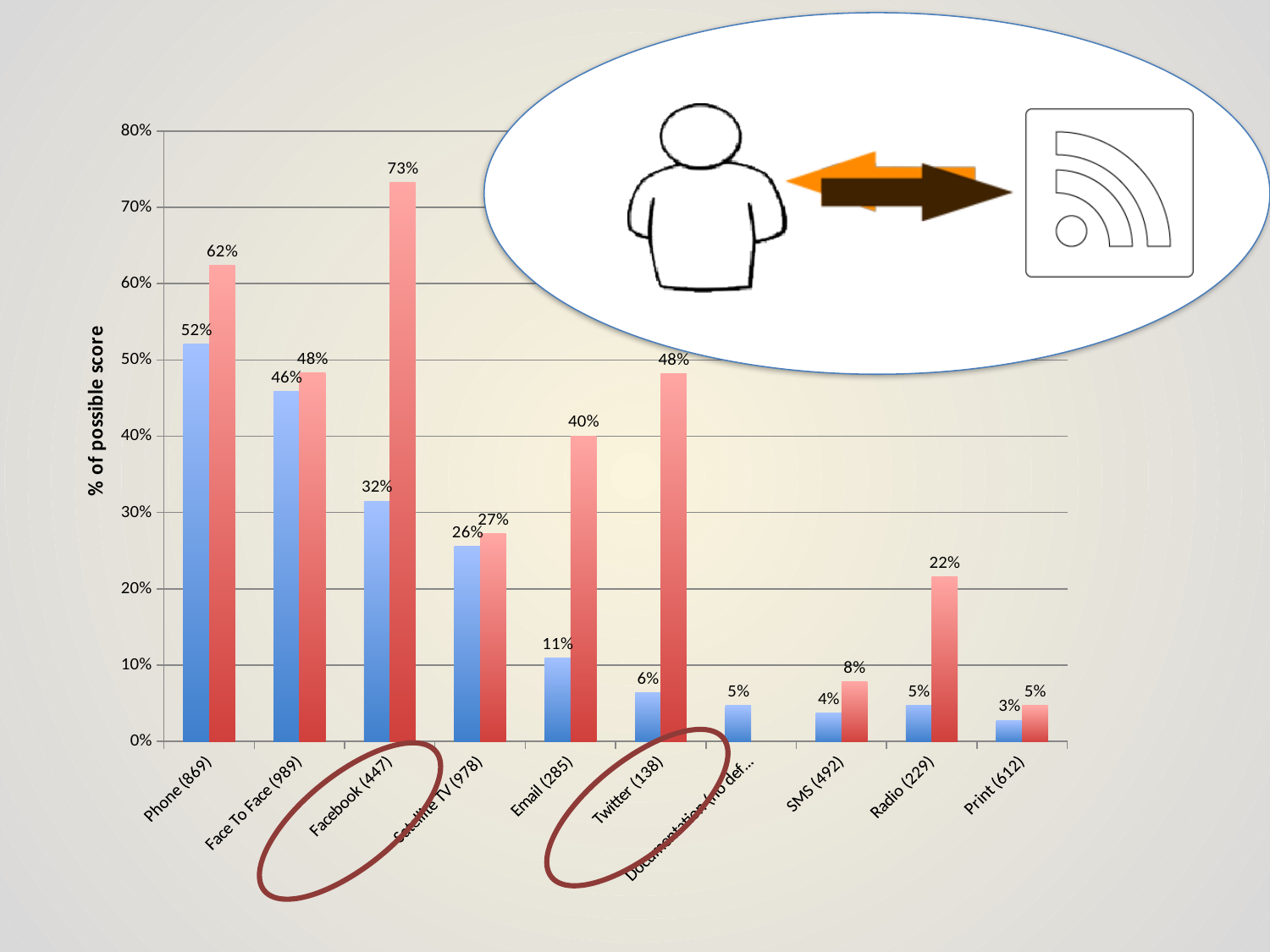
Which category has the highest red bar? Facebook (447) What is the value of the blue bar for Phone (869)? 52% What is the difference between the red and blue bars for Twitter (138)? 42 percentage points What is the value of the blue bar for Email (285)? 11% What is the value of the red bar for Facebook (447)? 73% How many categories are shown on the x axis? 10 Which category has the lowest blue bar? Print (612) What is the value of the red bar for Radio (229)? 22% What is the difference between the red and blue bars for Facebook (447)? 41 percentage points For Email (285), which is larger, the blue bar or the red bar? The red bar What kind of chart is shown on the slide? Bar chart What is the title of the vertical axis? % of possible score